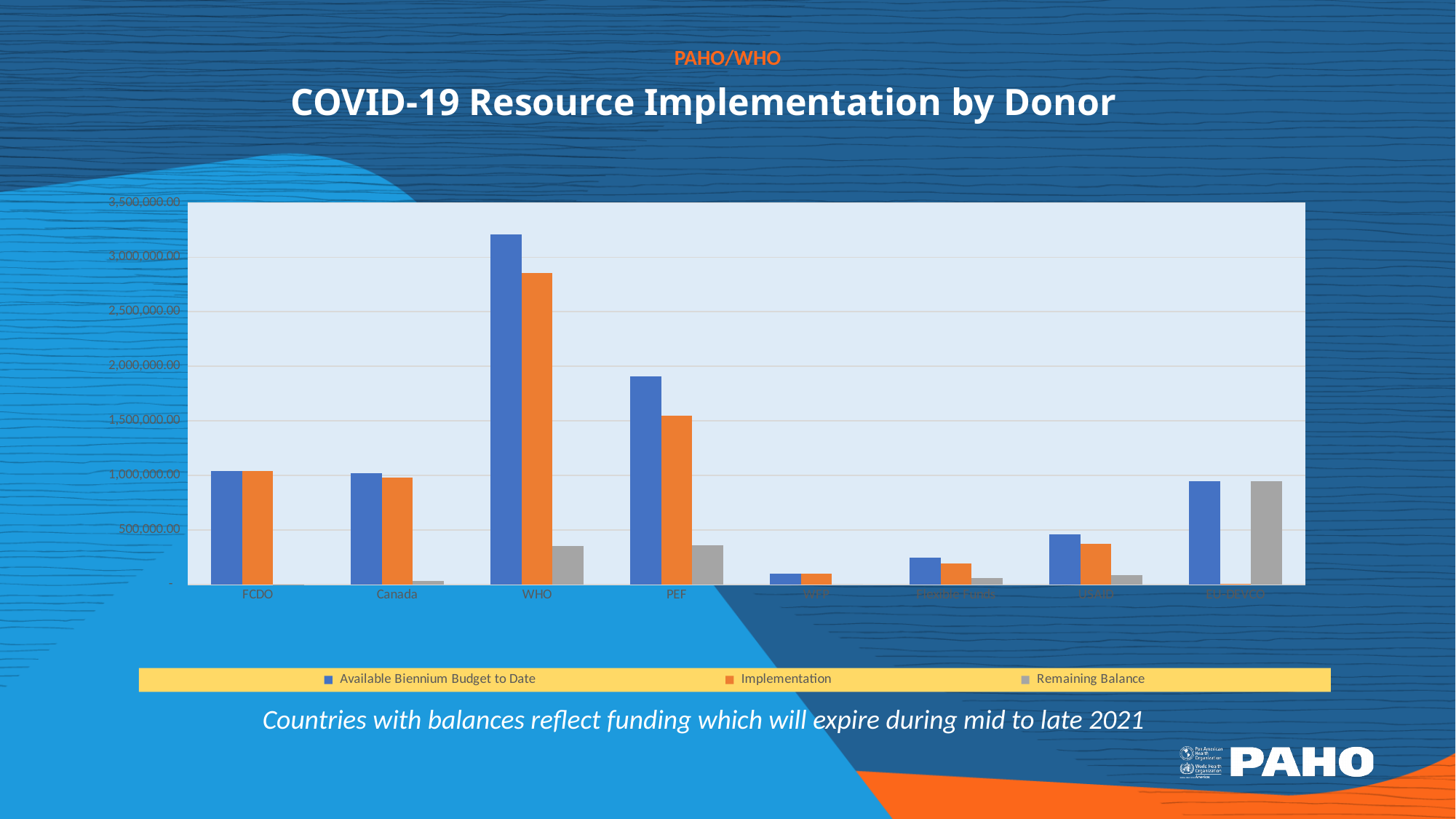
Which is larger, the Available Biennium Budget to Date for WHO or for PEF? WHO What is the title of the chart? COVID-19 Resource Implementation by Donor Is the Implementation value for WHO greater or less than 3,000,000.00? less Is the Available Biennium Budget to Date for WHO greater or less than 3,000,000.00? greater How many donor categories are plotted on the x axis? 8 Which colour represents the Implementation series in the legend? orange Which donor has the highest Available Biennium Budget to Date? WHO How many series does the legend list? 3 Which donor has the highest Implementation value? WHO What kind of chart is shown on the slide? bar chart Is the Remaining Balance for WHO greater or less than 500,000.00? less